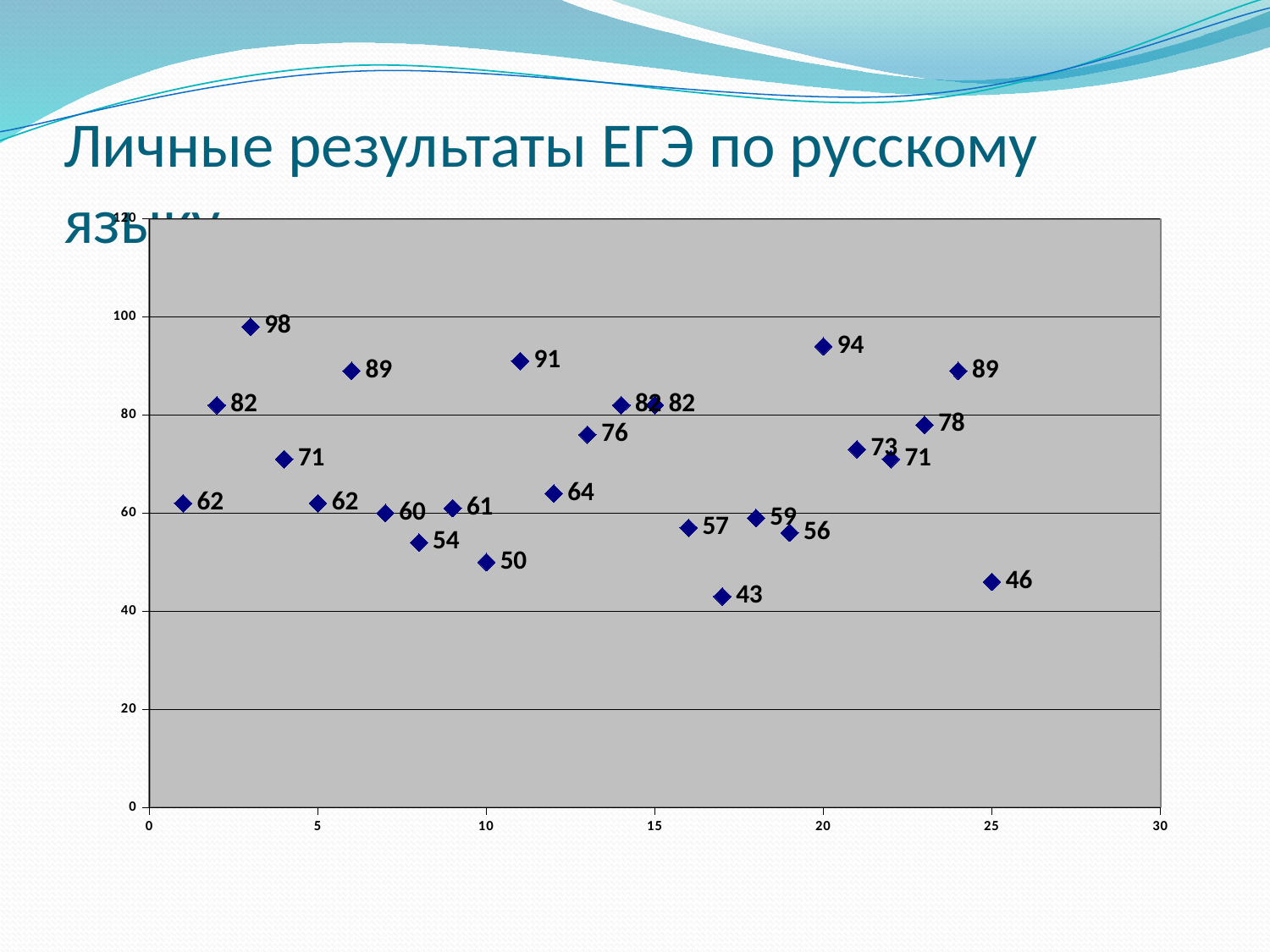
What is the title of the slide containing the chart? Личные результаты ЕГЭ по русскому языку What is the difference between the highest and lowest values on the chart? 55 How many data points are plotted on the chart? 25 What is the lowest value plotted on the chart? 43 What is the value of the point at x = 11? 91 What is the difference between the values at x = 6 and x = 10? 39 What is the value of the point at x = 25? 46 Is the value of the point at x = 17 greater or less than 60? less What is the highest value plotted on the chart? 98 What is the value of the point at x = 20? 94 Which is larger: the value at x = 3 or the value at x = 20? the value at x = 3 (98) What kind of chart is shown on the slide? scatter chart